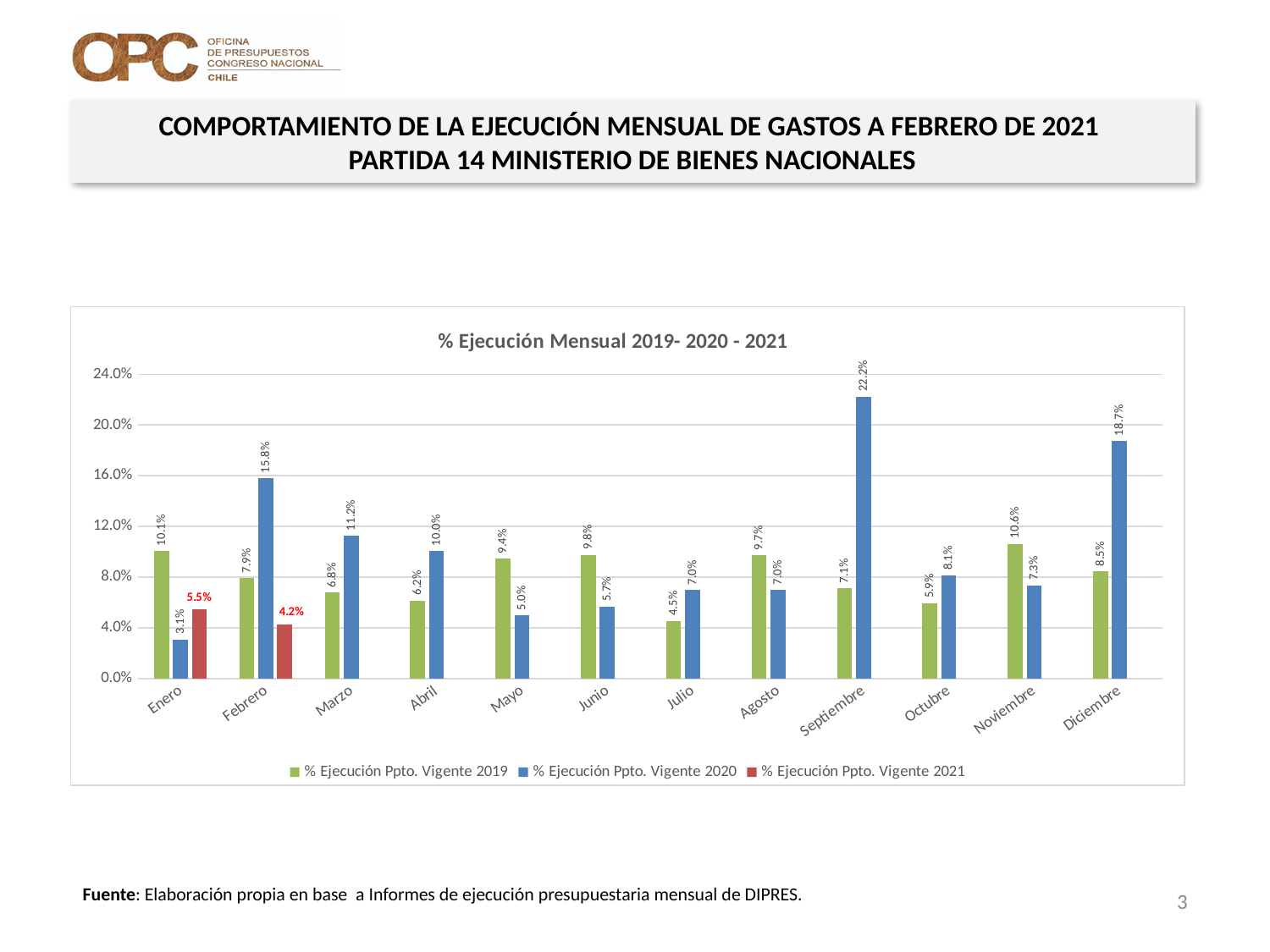
What is the value for % Ejecución Ppto. Vigente 2020 in Septiembre? 22.2% What is the title of the chart? % Ejecución Mensual 2019- 2020 - 2021 How many series does the legend list? 3 Which month has the highest value for % Ejecución Ppto. Vigente 2020? Septiembre How many months are shown on the x axis? 12 Which month has the lowest value for % Ejecución Ppto. Vigente 2019? Julio What is the value for % Ejecución Ppto. Vigente 2021 in Enero? 5.5% What is the value for % Ejecución Ppto. Vigente 2019 in Noviembre? 10.6% What is the difference between the 2020 and 2019 values in Febrero? 7.9% What kind of chart is shown on the slide? Bar chart Is the value for % Ejecución Ppto. Vigente 2020 in Diciembre greater or less than 16.0%? greater In Mayo, which series is larger: % Ejecución Ppto. Vigente 2019 or % Ejecución Ppto. Vigente 2020? % Ejecución Ppto. Vigente 2019